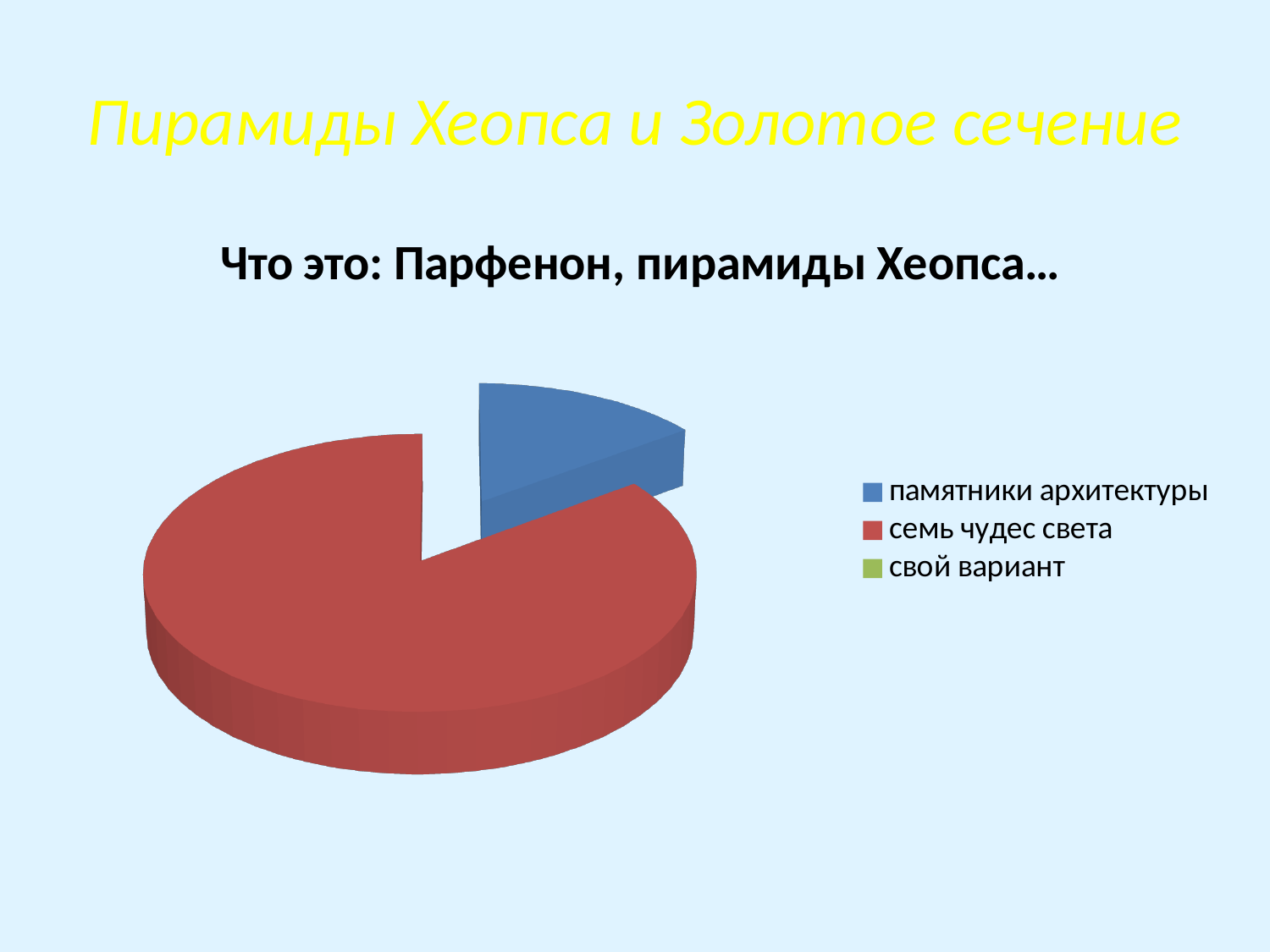
Which category has the largest slice of the pie? семь чудес света Which slice is larger: памятники архитектуры or семь чудес света? семь чудес света What is the title of the chart? Что это: Парфенон, пирамиды Хеопса… What kind of chart is shown on the slide? pie chart How many entries does the chart legend list? 3 What colour is the slice for семь чудес света? red Which legend entry is shown in blue? памятники архитектуры